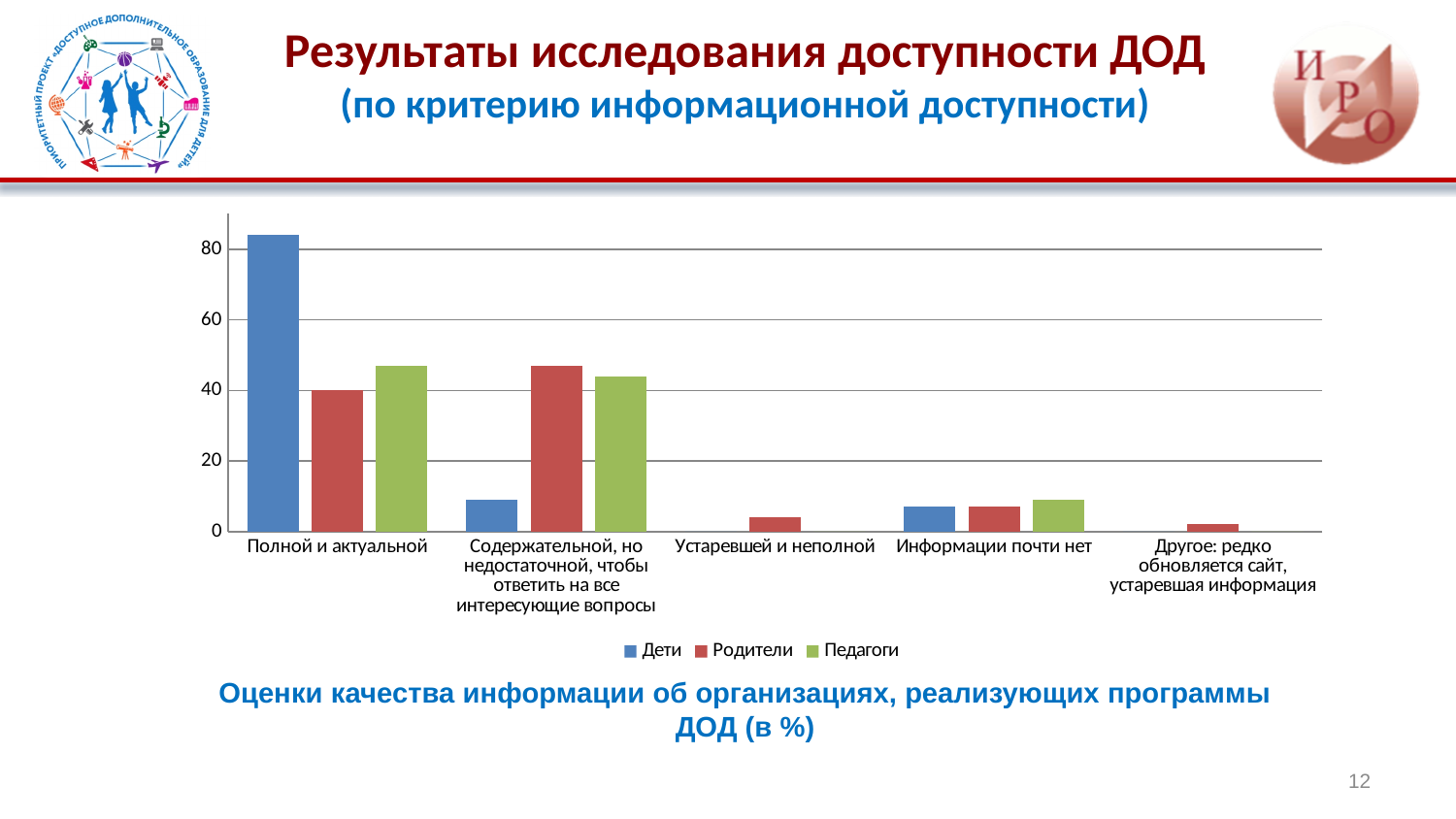
How many categories are shown on the x axis? 5 What kind of chart is shown on the slide? bar chart Which series has the highest value in the category "Информации почти нет"? Педагоги Which series has the highest value for the category "Полной и актуальной"? Дети How many series does the legend list? 3 Which series has the lowest value for the category "Полной и актуальной"? Родители Is the value for Дети in the category "Содержательной, но недостаточной, чтобы ответить на все интересующие вопросы" greater or less than 20? less Which is larger: the value for Дети or the value for Родители in the category "Содержательной, но недостаточной, чтобы ответить на все интересующие вопросы"? Родители Which series is shown in green in the legend? Педагоги Is the value for Дети in the category "Полной и актуальной" greater or less than 80? greater Is the value for Родители in the category "Содержательной, но недостаточной, чтобы ответить на все интересующие вопросы" greater or less than 40? greater Do the values for Дети rise or fall from the category "Полной и актуальной" to "Содержательной, но недостаточной, чтобы ответить на все интересующие вопросы"? fall